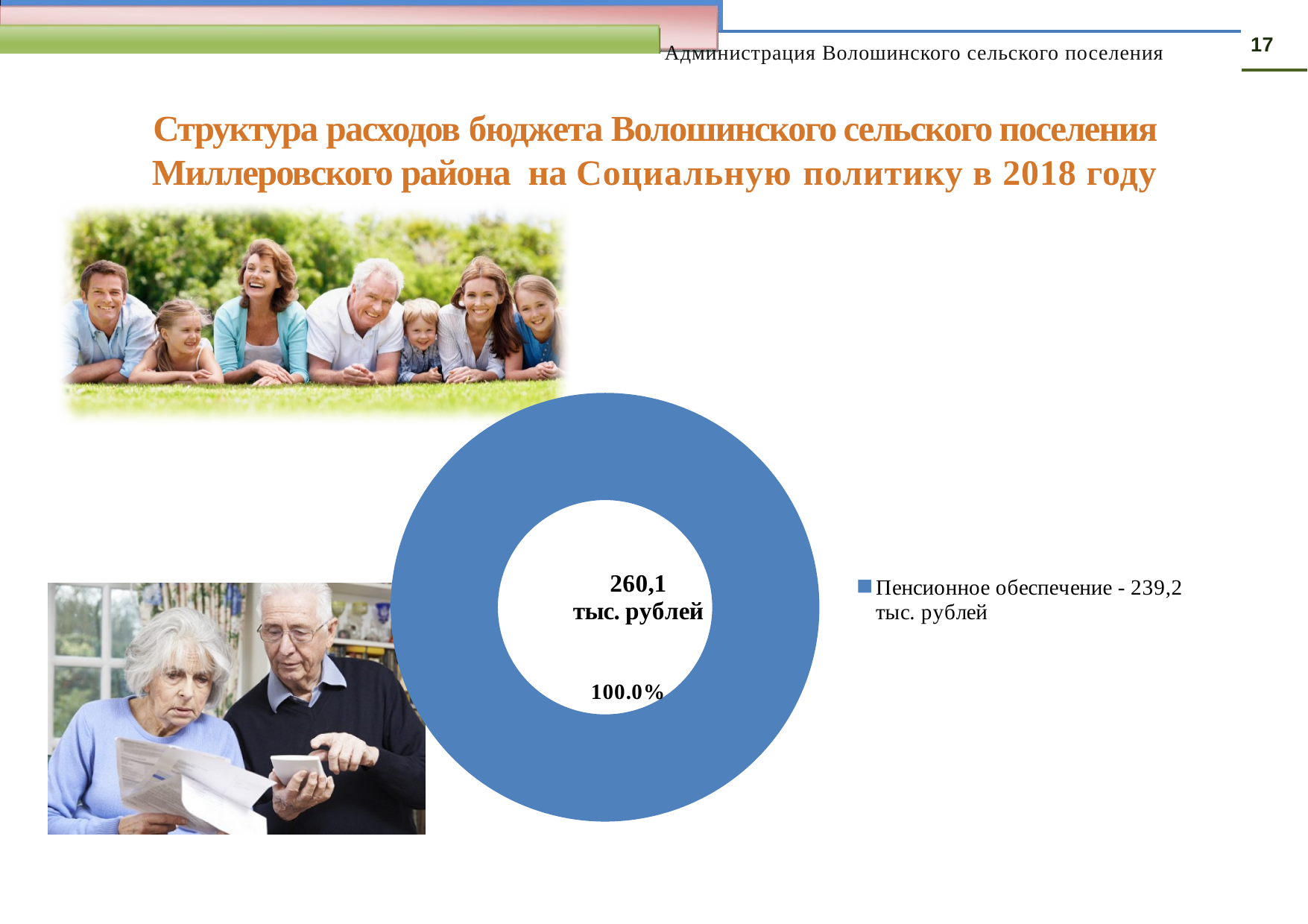
What share of the doughnut chart does the slice labelled 100.0% represent? 100.0% How many series does the legend of the chart list? 1 What colour is the slice of the doughnut chart? Blue What total value is printed in the centre of the doughnut chart? 260,1 тыс. рублей What is the name of the only category shown in the chart legend? Пенсионное обеспечение - 239,2 тыс. рублей What value is given in the legend for Пенсионное обеспечение? 239,2 тыс. рублей What kind of chart is shown on the slide? Doughnut (pie) chart How many slices does the doughnut chart have? 1 What percentage label is printed on the doughnut chart? 100.0%